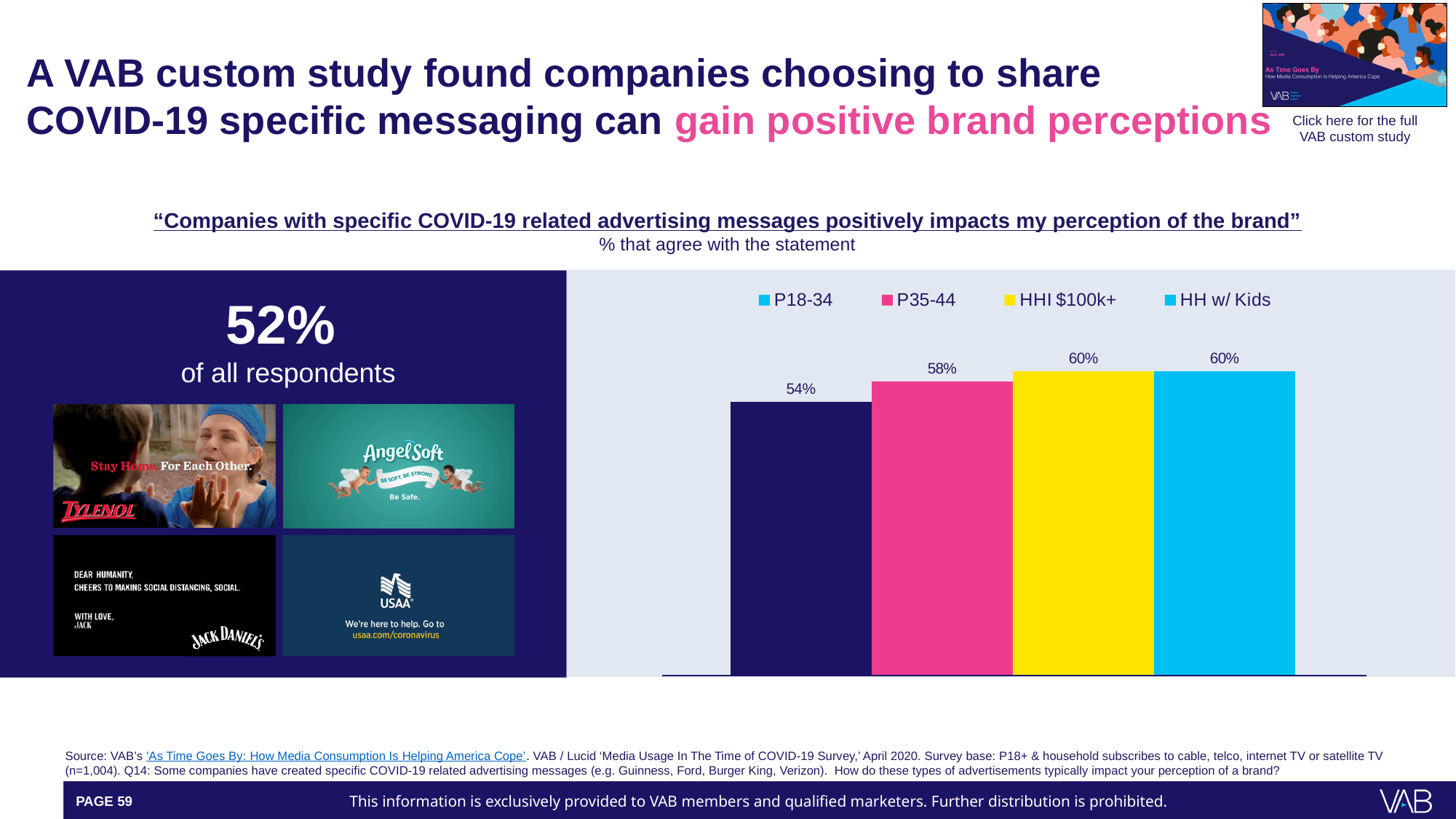
What kind of chart is shown on the slide? Bar chart What value is shown for the HHI $100k+ bar? 60% What colour is the P35-44 bar? Pink Which group has the lowest percentage agreeing with the statement? P18-34 What value is shown for the P35-44 bar? 58% What is the difference between the HHI $100k+ value and the P18-34 value? 6 percentage points What is the difference between the P35-44 value and the P18-34 value? 4 percentage points How many bars are plotted in the chart? 4 Which is larger, the value for P18-34 or the value for P35-44? P35-44 How many series does the chart legend list? 4 What percentage of P18-34 respondents agree that companies with specific COVID-19 related advertising messages positively impact their perception of the brand? 54% What value is shown for the HH w/ Kids bar? 60%